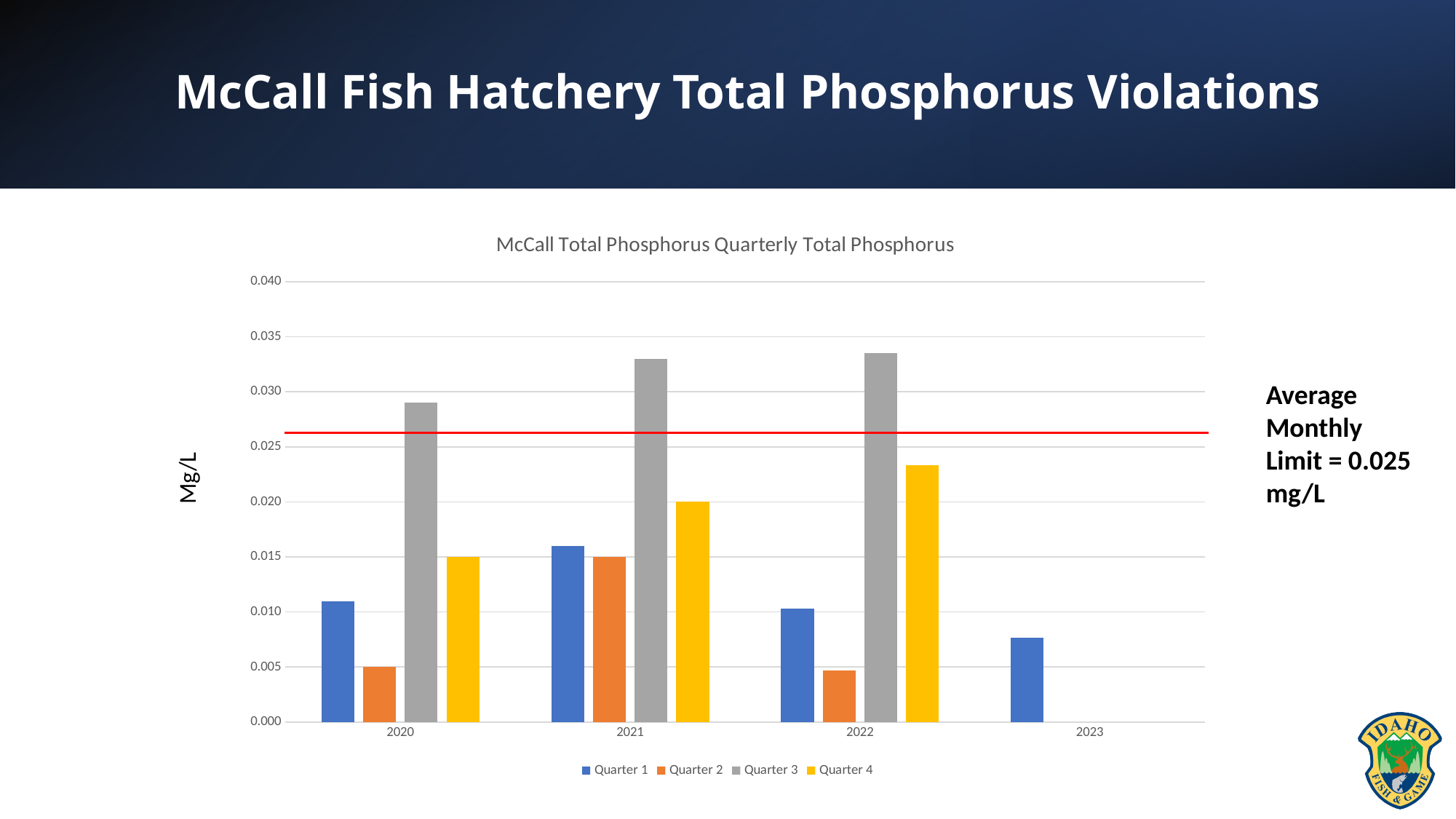
Which is larger, the Quarter 3 value for 2020 or the Quarter 3 value for 2022? 2022 What is the label on the y axis? Mg/L Do the Quarter 3 values rise or fall from 2020 to 2022? Rise What kind of chart is shown on the slide? Bar chart Which is larger, the Quarter 4 value for 2021 or the Quarter 4 value for 2022? 2022 How many years are shown on the x axis? 4 How many series does the legend list? 4 Is the value for Quarter 3 in 2021 greater or less than 0.030? greater Is the value for Quarter 1 in 2023 greater or less than 0.010? less Which quarter has the lowest value in 2022? Quarter 2 Which quarter has the highest value in 2022? Quarter 3